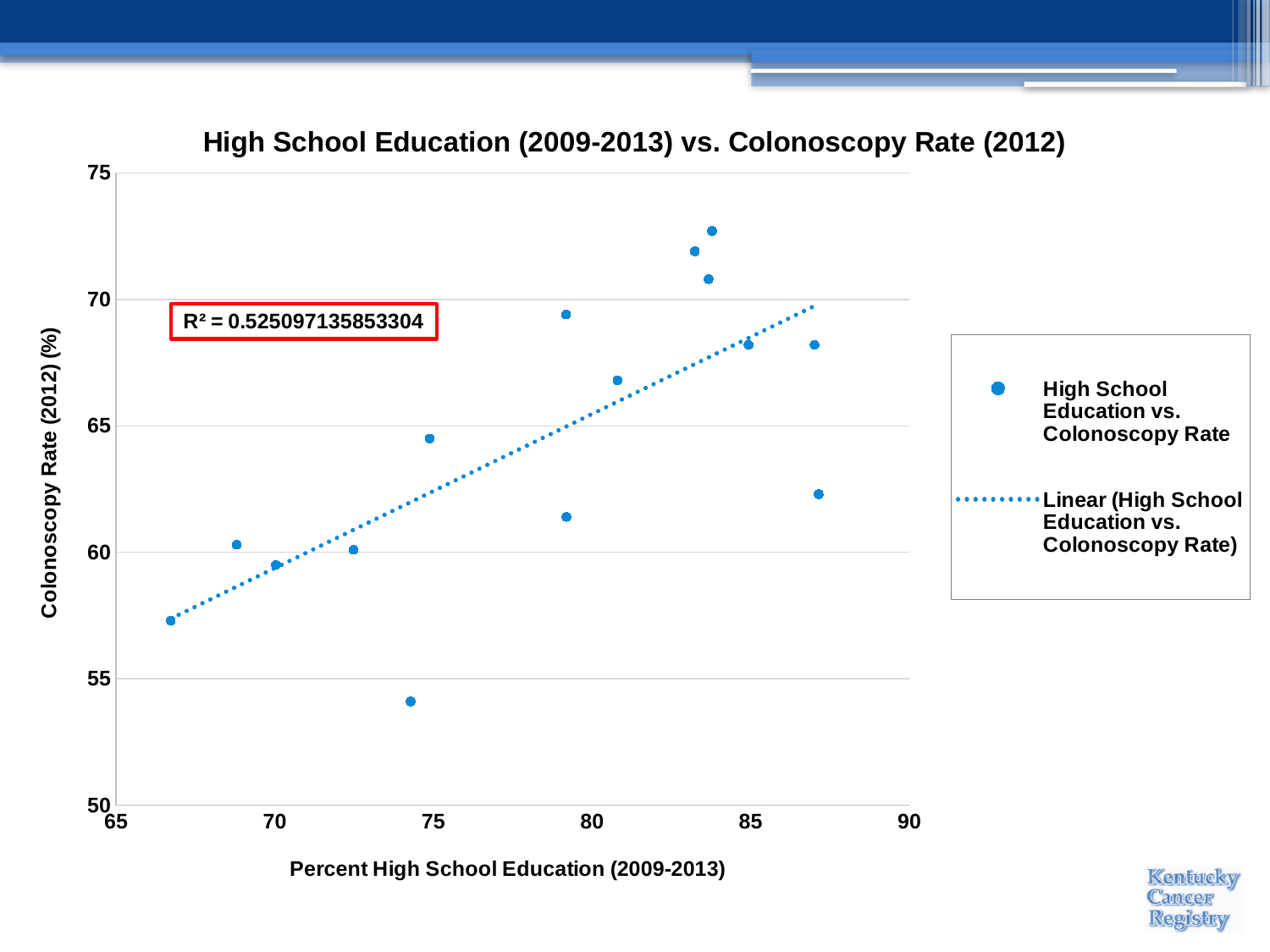
What is the highest value shown on the y axis? 75 Does the linear trendline rise or fall as percent high school education increases? Rises Is the colonoscopy rate for the point with the lowest percent high school education greater or less than 60? less What kind of chart is shown on the slide? Scatter chart Is the highest colonoscopy rate plotted on the chart greater or less than 70? greater What is the label of the x axis? Percent High School Education (2009-2013) Is the lowest colonoscopy rate plotted on the chart greater or less than 55? less How many series does the legend list? 2 What is the label of the y axis? Colonoscopy Rate (2012) (%)